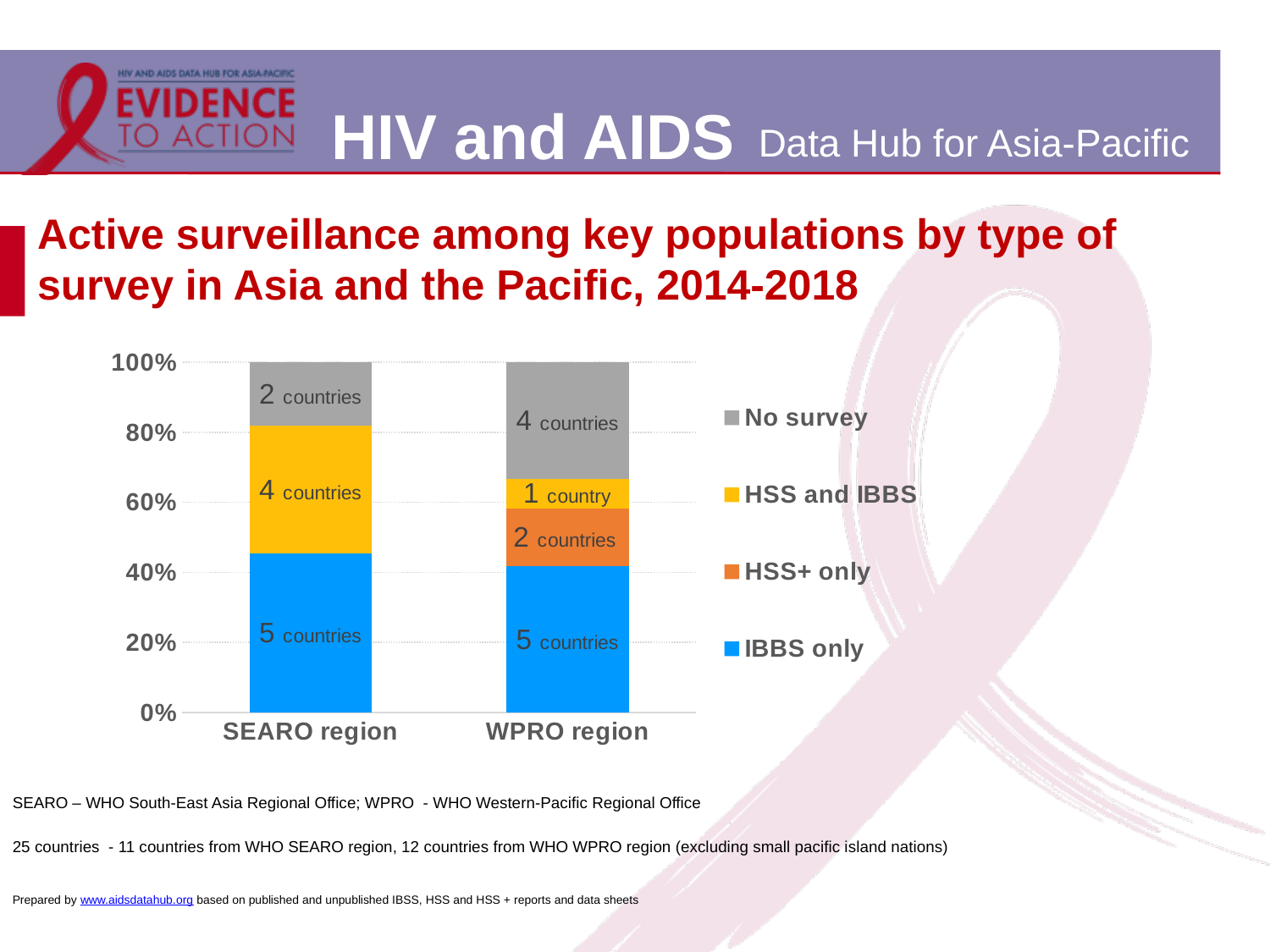
What is the total number of countries shown in the WPRO region bar? 12 countries What is the total number of countries shown in the SEARO region bar? 11 countries How many regions are shown on the x axis of the chart? 2 How many series does the chart legend list? 4 How many countries in the WPRO region have both HSS and IBBS? 1 country How many countries in the SEARO region have both HSS and IBBS? 4 countries Which region has more countries with no survey, SEARO or WPRO? WPRO region How many countries in the WPRO region have HSS+ only? 2 countries What is the difference in the number of countries with HSS and IBBS between the SEARO region and the WPRO region? 3 countries What type of chart is used on the slide? Stacked bar chart How many countries in the SEARO region have IBBS only surveillance? 5 countries How many countries in the WPRO region have no survey? 4 countries